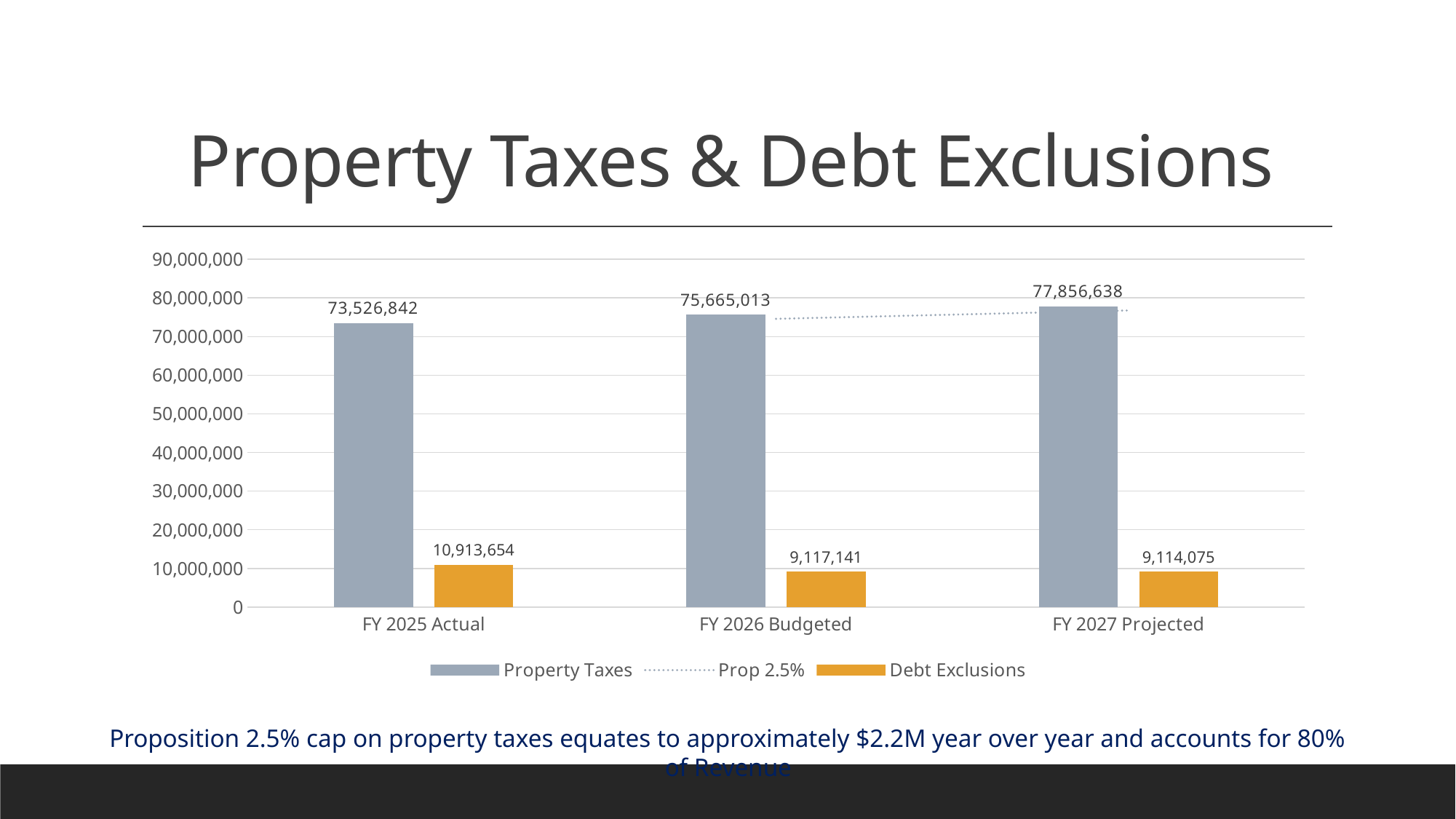
Which is larger: Debt Exclusions for FY 2025 Actual or Debt Exclusions for FY 2026 Budgeted? FY 2025 Actual What is the Debt Exclusions value for FY 2025 Actual? 10,913,654 What is the difference between the Property Taxes values for FY 2026 Budgeted and FY 2025 Actual? 2,138,171 Do the Property Taxes values rise or fall from FY 2025 Actual to FY 2027 Projected? rise How many fiscal year categories are shown on the x axis? 3 Which fiscal year has the highest Property Taxes value? FY 2027 Projected What is the Property Taxes value for FY 2027 Projected? 77,856,638 What is the Debt Exclusions value for FY 2027 Projected? 9,114,075 What is the difference between the Debt Exclusions values for FY 2025 Actual and FY 2026 Budgeted? 1,796,513 Which fiscal year has the lowest Property Taxes value? FY 2025 Actual How many series does the legend list? 3 What is the Property Taxes value for FY 2026 Budgeted? 75,665,013